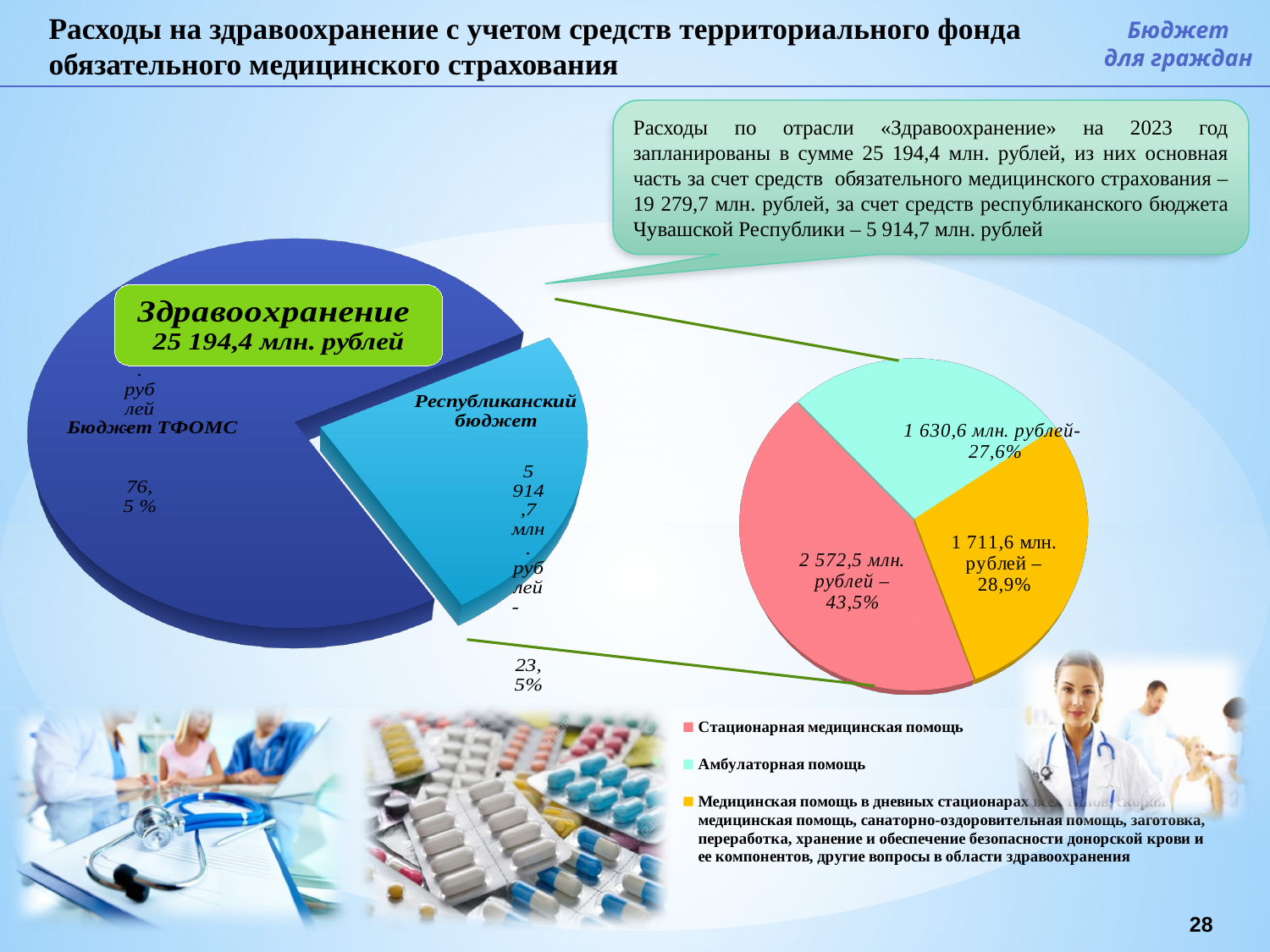
In the right pie chart, which category has the smallest slice? Амбулаторная помощь In the right pie chart, what share does Амбулаторная помощь have? 27,6% In the left pie chart, what value is shown for Республиканский бюджет? 5 914,7 млн. рублей In the right pie chart, which category has the largest slice? Стационарная медицинская помощь In the right pie chart, what value is shown for Стационарная медицинская помощь? 2 572,5 млн. рублей In the right pie chart, what colour is the slice for Амбулаторная помощь? light cyan How many slices does the right pie chart have? 3 In the left pie chart, what share does Бюджет ТФОМС have? 76,5 % In the right pie chart, what share does the orange slice (Медицинская помощь в дневных стационарах...) have? 28,9% What type of chart is the left chart on the slide? pie chart In the left pie chart, which slice is larger: Бюджет ТФОМС or Республиканский бюджет? Бюджет ТФОМС